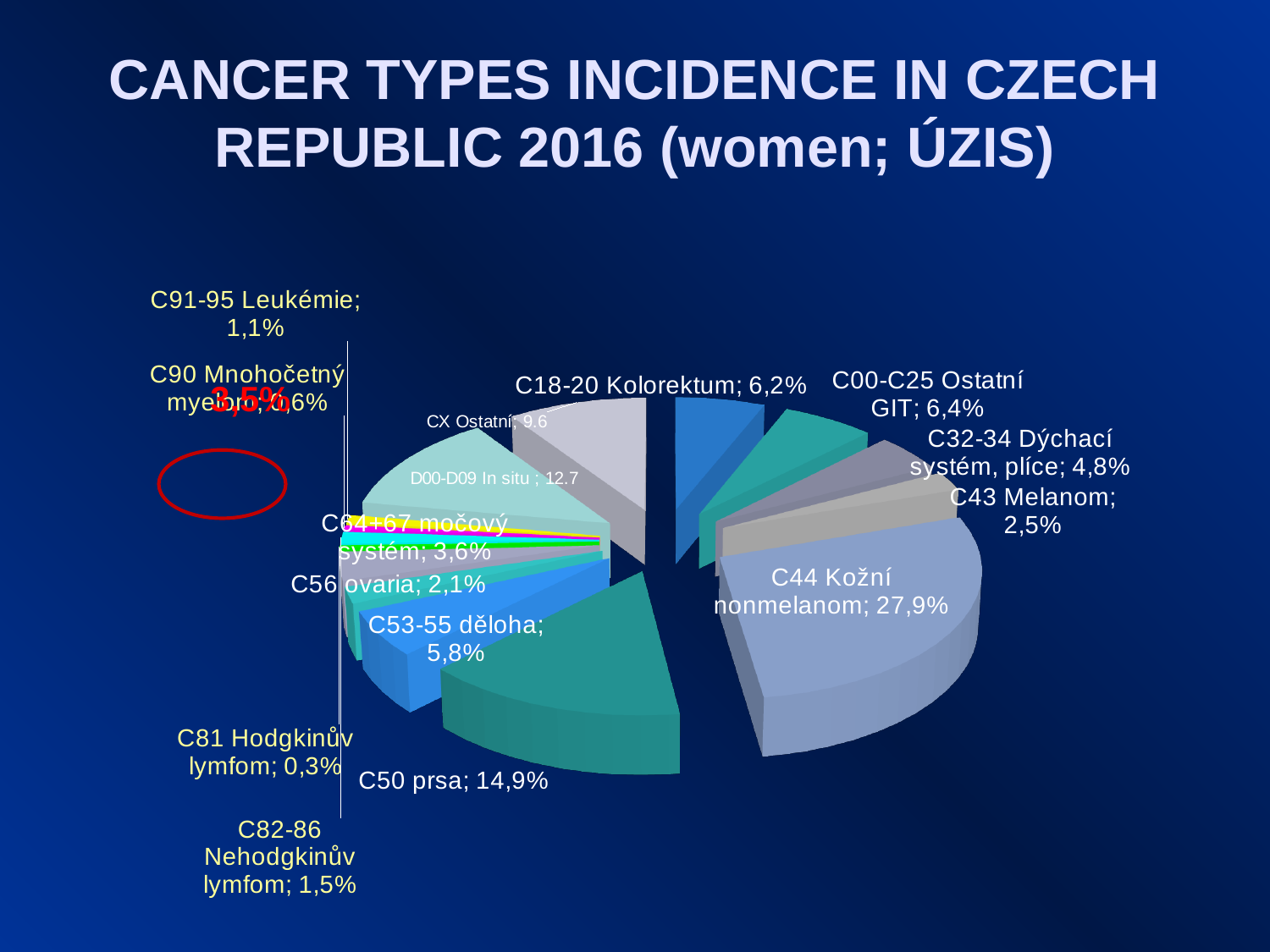
What percentage is shown for C53-55 děloha? 5,8% What percentage is shown for C43 Melanom? 2,5% What kind of chart is shown on the slide? pie chart What is the difference in percentage points between C00-C25 Ostatní GIT and C18-20 Kolorektum? 0,2% What percentage is shown for C50 prsa? 14,9% Which cancer type has the smallest share of the pie? C81 Hodgkinův lymfom What is the title of the chart on the slide? CANCER TYPES INCIDENCE IN CZECH REPUBLIC 2016 (women; ÚZIS) What percentage is shown for C44 Kožní nonmelanom? 27,9% Which has a larger share: C50 prsa or D00-D09 In situ? C50 prsa Which cancer type has the largest share of the pie? C44 Kožní nonmelanom What percentage is shown for C18-20 Kolorektum? 6,2% What is the difference in percentage points between C44 Kožní nonmelanom and C50 prsa? 13,0%